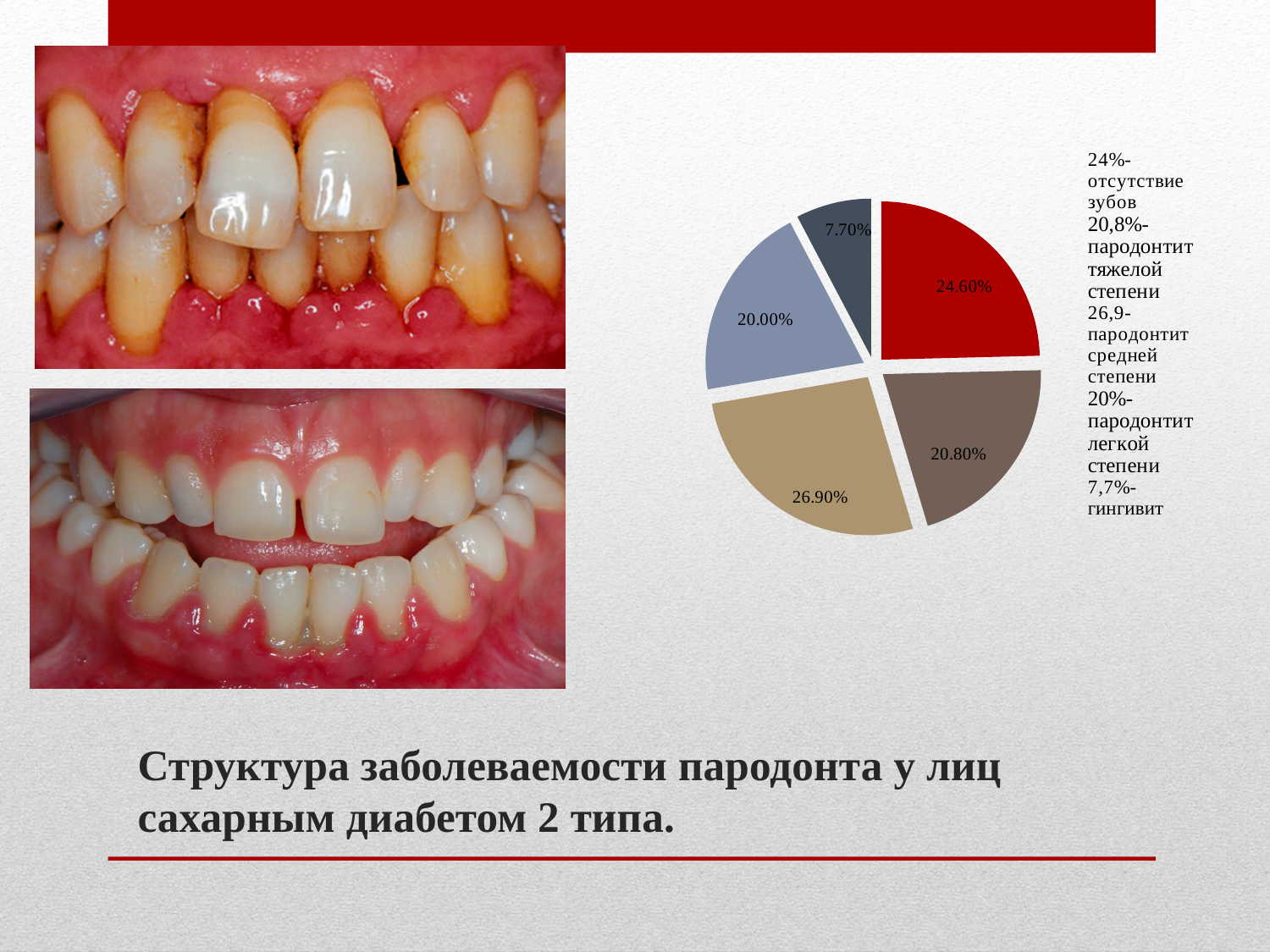
What kind of chart is shown on the slide? pie chart According to the text next to the pie chart, which category corresponds to 7,7%? гингивит What is the value of the largest slice in the pie chart? 26.90% How many slices does the pie chart have? 5 Which is larger in the pie chart: the red slice or the brown slice? the red slice (24.60%) What value is labelled on the dark grey slice of the pie chart? 7.70% According to the text next to the pie chart, which category corresponds to 26,9%? пародонтит средней степени What is the title written at the bottom of the slide? Структура заболеваемости пародонта у лиц сахарным диабетом 2 типа. What value is labelled on the red slice of the pie chart? 24.60% What is the difference between the largest slice (26.90%) and the smallest slice (7.70%) in the pie chart? 19.20% What is the difference between the 24.60% slice and the 20.00% slice in the pie chart? 4.60% What is the value of the smallest slice in the pie chart? 7.70%